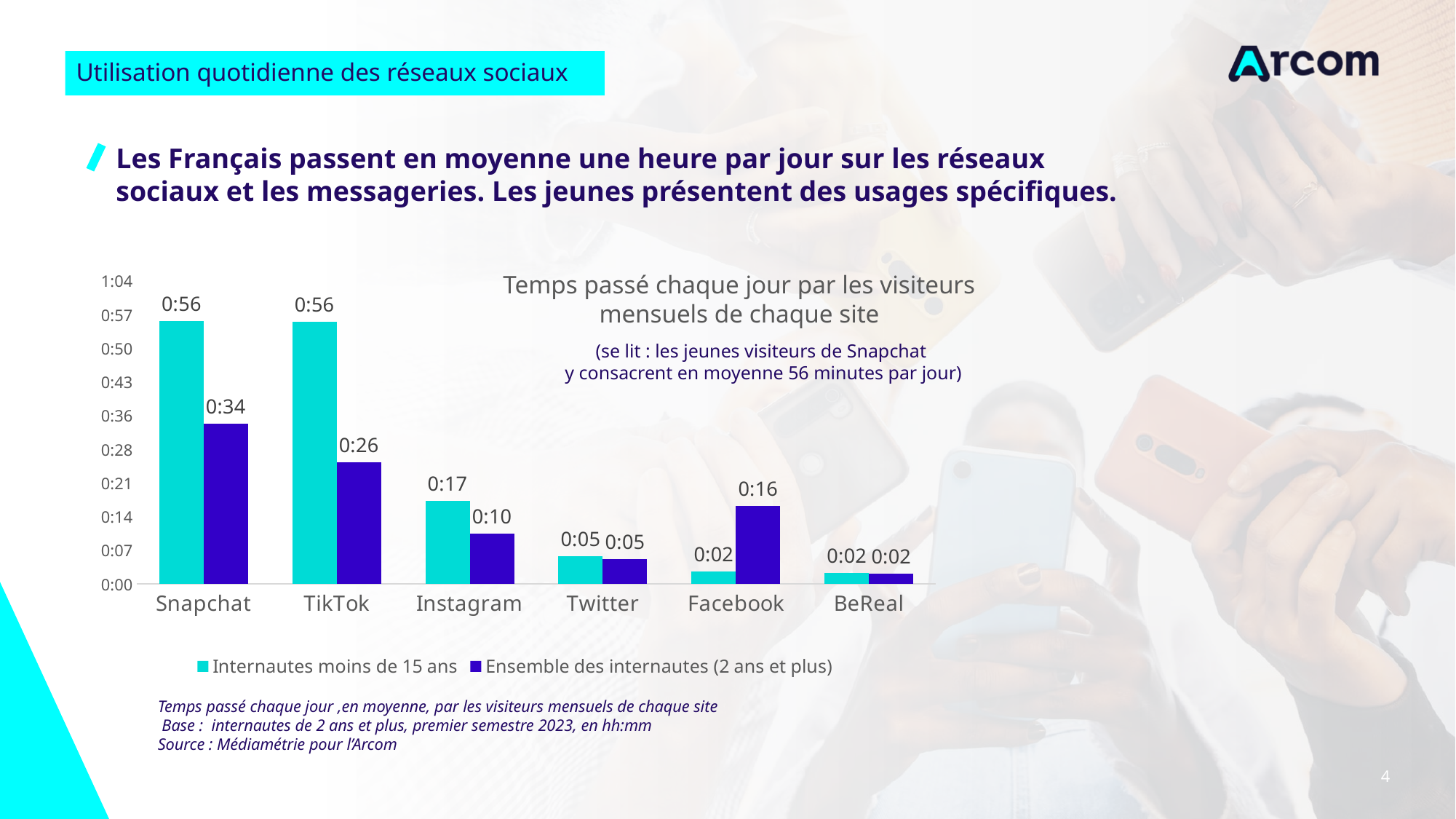
What is the title of the chart? Temps passé chaque jour par les visiteurs mensuels de chaque site What kind of chart is shown on the slide? Bar chart How many series does the legend list? 2 How many categories are shown on the x axis? 6 Which category has the lowest value for the series 'Ensemble des internautes (2 ans et plus)'? BeReal What is the value for Snapchat for the series 'Internautes moins de 15 ans'? 0:56 What is the value for Instagram for the series 'Internautes moins de 15 ans'? 0:17 Which category has the highest value for the series 'Ensemble des internautes (2 ans et plus)'? Snapchat For Facebook, which series has the larger value: 'Internautes moins de 15 ans' or 'Ensemble des internautes (2 ans et plus)'? Ensemble des internautes (2 ans et plus) What is the difference between the two series for Snapchat? 0:22 What is the value for TikTok for the series 'Ensemble des internautes (2 ans et plus)'? 0:26 What is the value for Facebook for the series 'Ensemble des internautes (2 ans et plus)'? 0:16